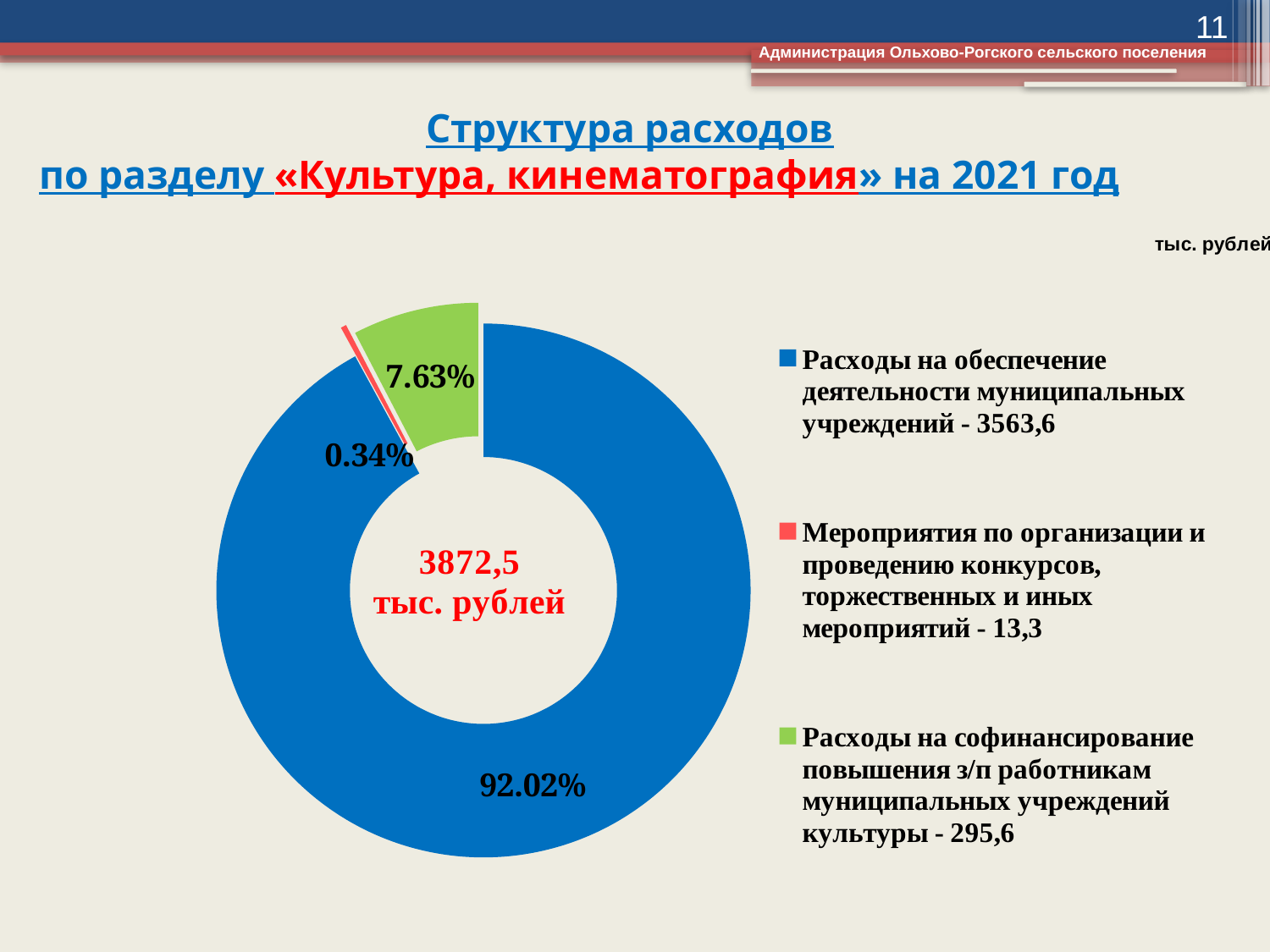
How many entries does the legend list? 3 What share of the chart is labelled for 'Расходы на обеспечение деятельности муниципальных учреждений'? 92.02% What value (тыс. рублей) is given in the legend for 'Расходы на софинансирование повышения з/п работникам муниципальных учреждений культуры'? 295,6 How many slices does the chart have? 3 Which category has the largest share of the chart? Расходы на обеспечение деятельности муниципальных учреждений Which category has the smallest share of the chart? Мероприятия по организации и проведению конкурсов, торжественных и иных мероприятий What share of the chart is labelled for 'Расходы на софинансирование повышения з/п работникам муниципальных учреждений культуры'? 7.63% What share of the chart is labelled for 'Мероприятия по организации и проведению конкурсов, торжественных и иных мероприятий'? 0.34% What value (тыс. рублей) is given in the legend for 'Расходы на обеспечение деятельности муниципальных учреждений'? 3563,6 What total amount is shown in the centre of the chart? 3872,5 тыс. рублей What kind of chart is shown on the slide? Doughnut (pie) chart What value (тыс. рублей) is given in the legend for 'Мероприятия по организации и проведению конкурсов, торжественных и иных мероприятий'? 13,3